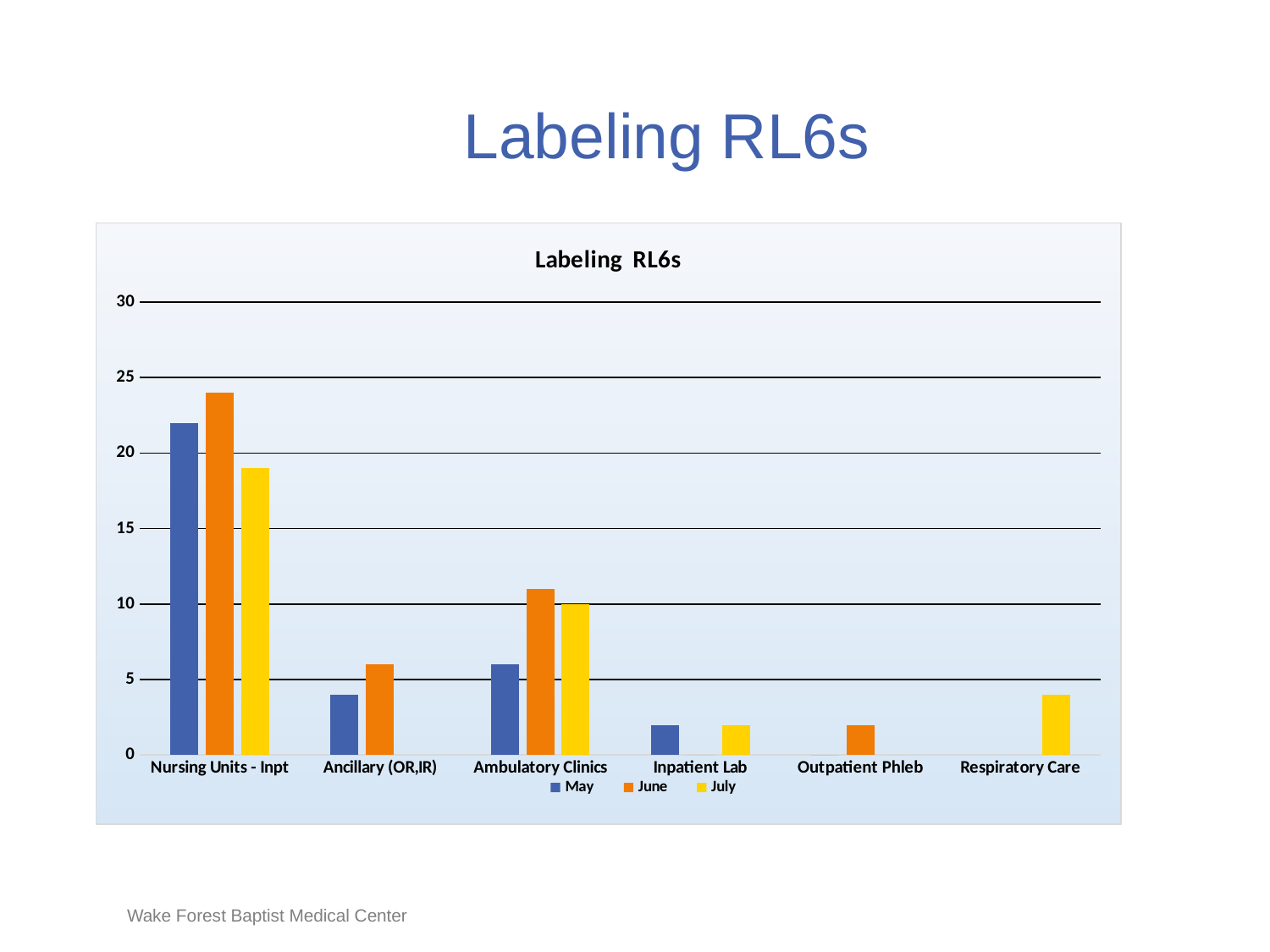
Which is larger for Nursing Units - Inpt, the May value or the July value? May Which series is shown in orange in the chart's legend? June How many series does the chart's legend list? 3 What is the title of the chart? Labeling RL6s For Nursing Units - Inpt, which month has the tallest bar? June Is the June value for Nursing Units - Inpt greater or less than 20? greater Is the July value for Nursing Units - Inpt greater or less than 20? less How many categories are shown on the x axis of the chart? 6 Is the May value for Ancillary (OR,IR) greater or less than 5? less What kind of chart is shown on the slide? bar chart Which category has the highest bars in the chart? Nursing Units - Inpt